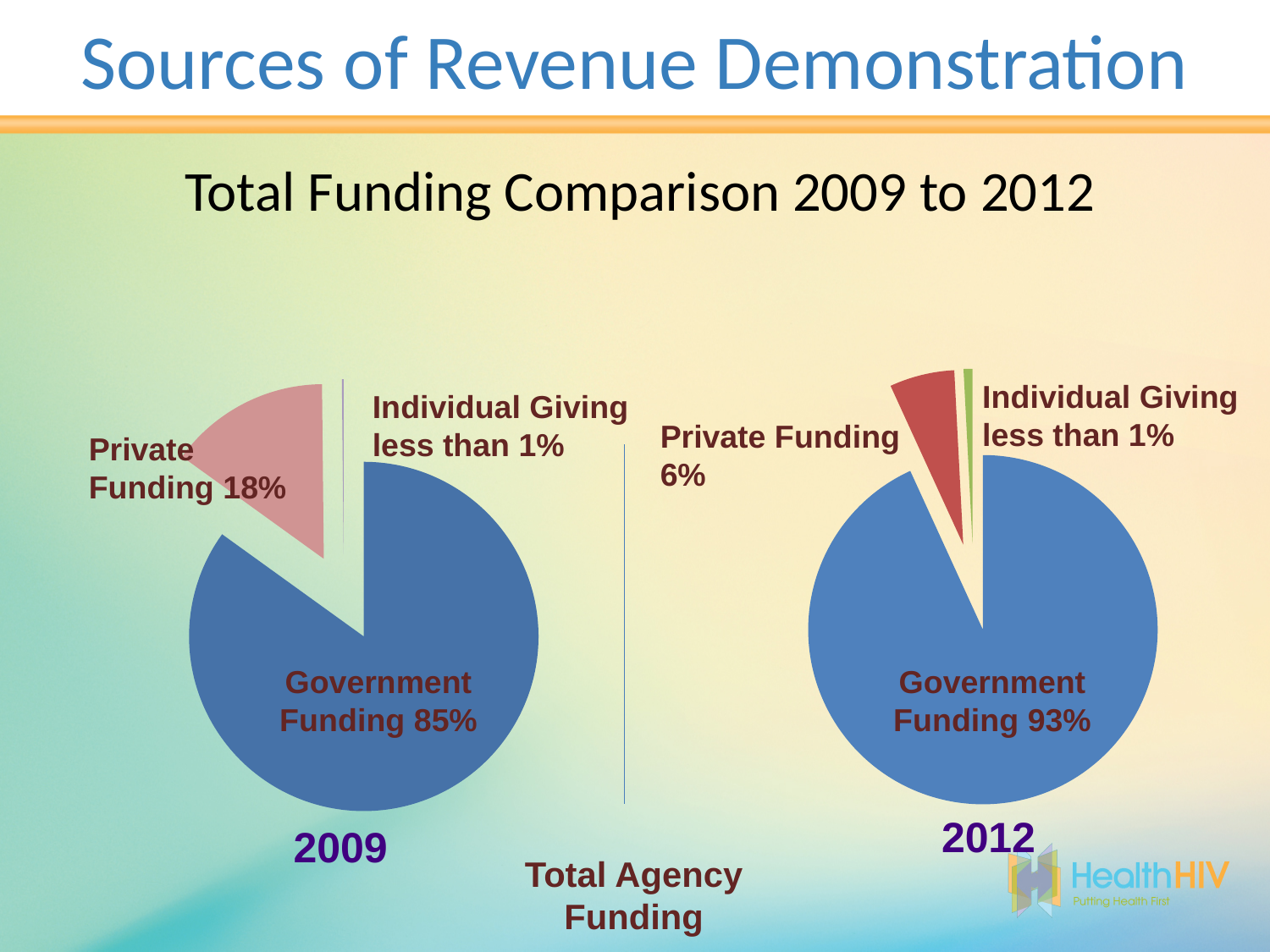
In the 2009 pie chart, what share is labelled for Government Funding? 85% What is the title shown above the two pie charts? Total Funding Comparison 2009 to 2012 How many slices does the 2009 pie chart have? 3 In the 2012 pie chart, what share is labelled for Private Funding? 6% By how many percentage points did the Government Funding share increase from the 2009 pie chart to the 2012 pie chart? 8 Which is larger: the Private Funding share in the 2009 pie chart or in the 2012 pie chart? 2009 In the 2009 pie chart, which category has the largest slice? Government Funding In the 2009 pie chart, what share is labelled for Private Funding? 18% In the 2012 pie chart, what share is labelled for Government Funding? 93% What kind of charts are shown on the slide? Pie charts In the 2012 pie chart, which category has the smallest slice? Individual Giving In the 2012 pie chart, what share is labelled for Individual Giving? less than 1%